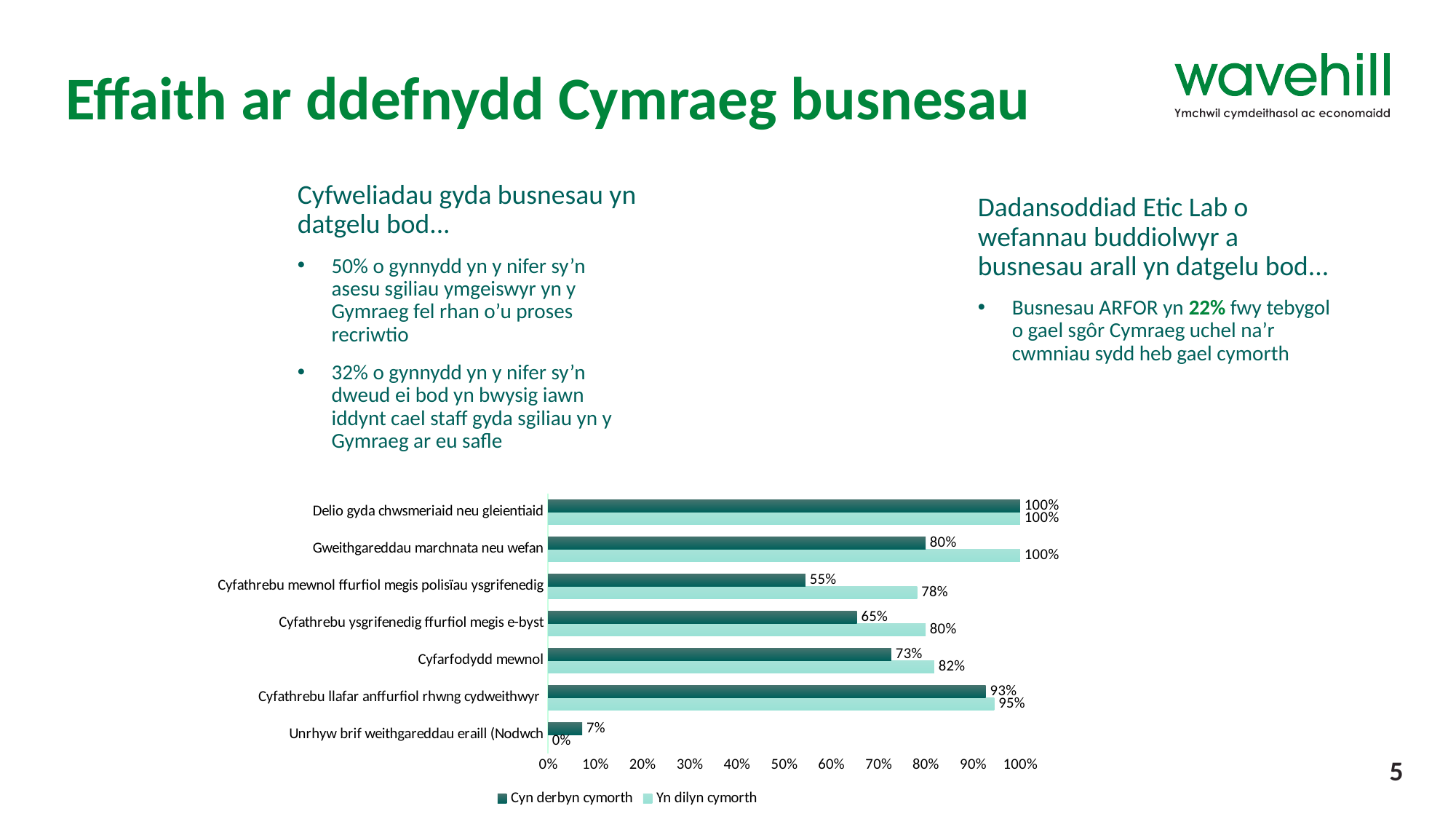
Which category has the lowest value for 'Yn dilyn cymorth'? Unrhyw brif weithgareddau eraill (Nodwch How many categories are shown on the chart? 7 What is the value for 'Cyn derbyn cymorth' for 'Gweithgareddau marchnata neu wefan'? 80% Which category has the lowest value for 'Cyn derbyn cymorth'? Unrhyw brif weithgareddau eraill (Nodwch How many series does the chart legend list? 2 What is the difference between the 'Yn dilyn cymorth' and 'Cyn derbyn cymorth' values for 'Cyfathrebu mewnol ffurfiol megis polisïau ysgrifenedig'? 23% What is the value for 'Yn dilyn cymorth' for 'Cyfathrebu mewnol ffurfiol megis polisïau ysgrifenedig'? 78% What is the value for 'Cyn derbyn cymorth' for 'Cyfarfodydd mewnol'? 73% What is the difference between the 'Yn dilyn cymorth' and 'Cyn derbyn cymorth' values for 'Cyfathrebu ysgrifenedig ffurfiol megis e-byst'? 15% Which series is shown in the darker green colour in the chart? Cyn derbyn cymorth For 'Cyfathrebu llafar anffurfiol rhwng cydweithwyr', which is larger: 'Cyn derbyn cymorth' or 'Yn dilyn cymorth'? Yn dilyn cymorth What type of chart is shown on the slide? Bar chart